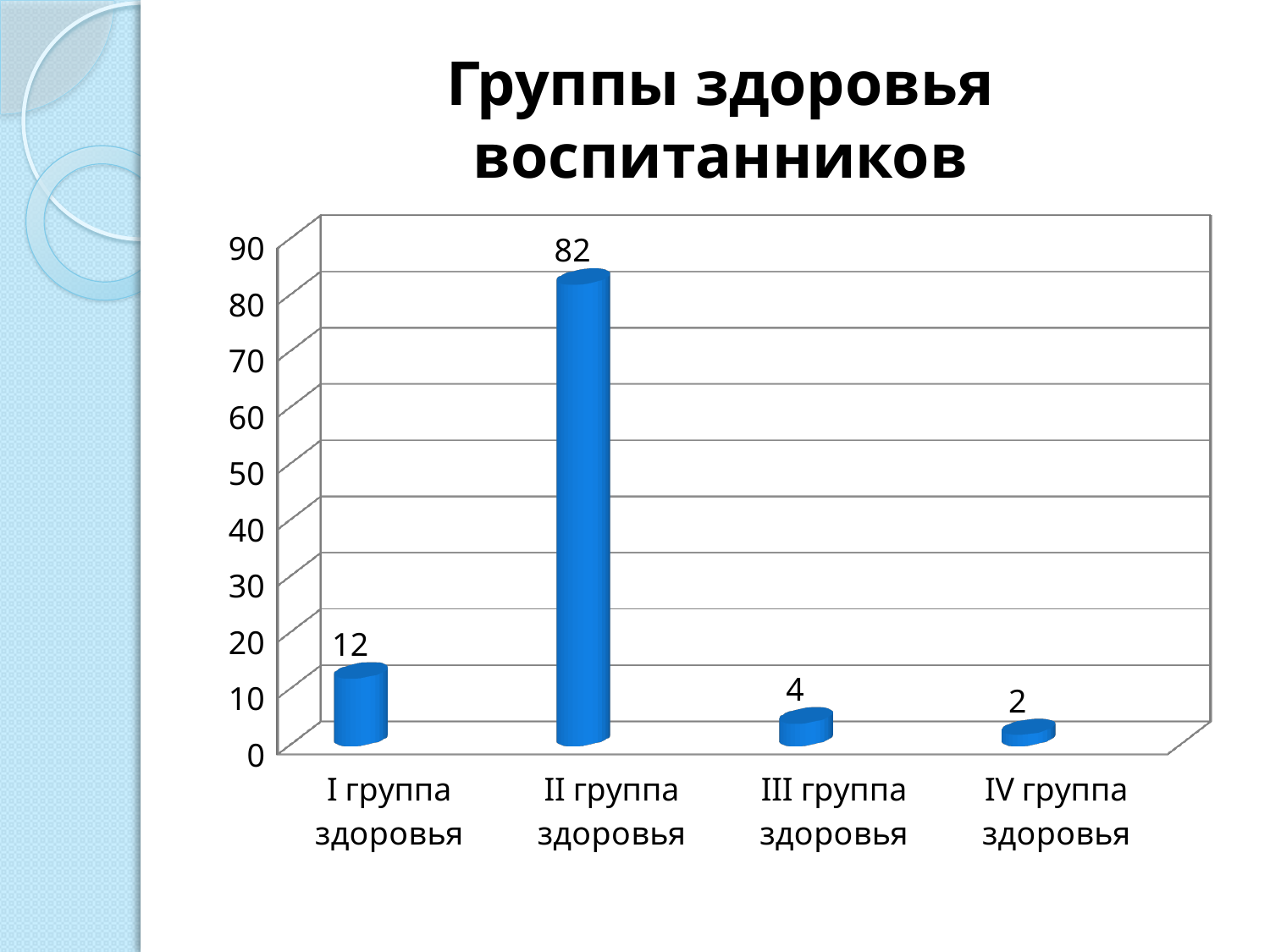
Which category has the highest value? II группа здоровья What is the value for I группа здоровья? 12 What is the value for IV группа здоровья? 2 What is the difference between the values for III группа здоровья and IV группа здоровья? 2 Which is larger, the value for I группа здоровья or the value for III группа здоровья? I группа здоровья Is the value for II группа здоровья greater or less than 80? greater What is the value for II группа здоровья? 82 What kind of chart is shown on the slide? bar chart What is the value for III группа здоровья? 4 What is the difference between the values for II группа здоровья and I группа здоровья? 70 Which category has the lowest value? IV группа здоровья How many categories are shown on the chart? 4